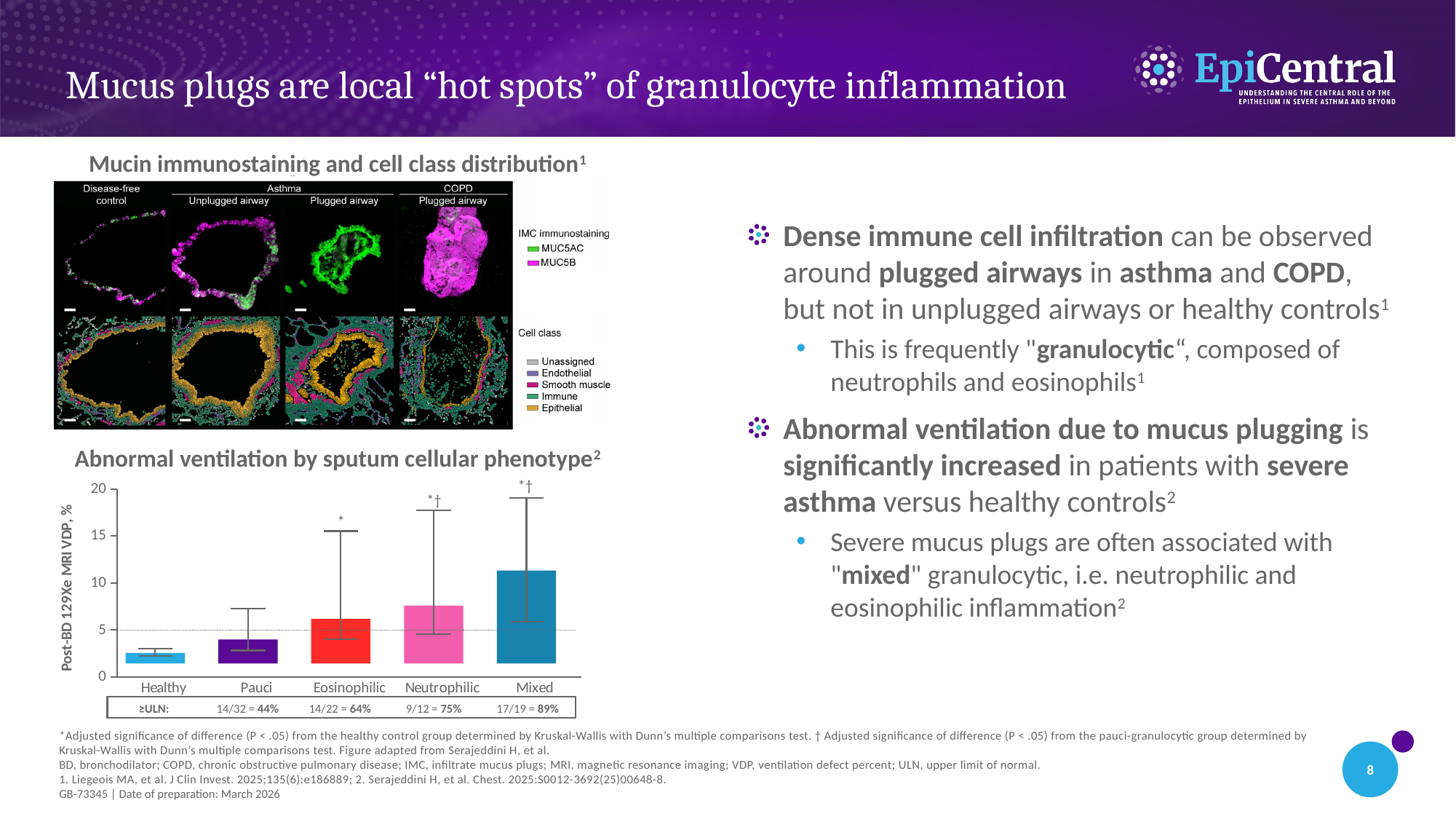
In the 'Abnormal ventilation by sputum cellular phenotype' chart, what is the ≥ULN fraction shown for the Eosinophilic group? 14/22 = 64% In the 'Abnormal ventilation by sputum cellular phenotype' chart, is the bar for Eosinophilic greater or less than 5? greater What kind of chart is 'Abnormal ventilation by sputum cellular phenotype'? Bar chart In the 'Abnormal ventilation by sputum cellular phenotype' chart, which bar is taller, Neutrophilic or Pauci? Neutrophilic In the 'Abnormal ventilation by sputum cellular phenotype' chart, which category has the highest bar? Mixed In the 'Abnormal ventilation by sputum cellular phenotype' chart, which category has the lowest bar? Healthy In the 'Abnormal ventilation by sputum cellular phenotype' chart, is the bar for Mixed greater or less than 10? greater In the 'Abnormal ventilation by sputum cellular phenotype' chart, what percentage of the Mixed group is ≥ULN? 89% What is the y-axis label of the 'Abnormal ventilation by sputum cellular phenotype' chart? Post-BD 129Xe MRI VDP, % In the 'Abnormal ventilation by sputum cellular phenotype' chart, is the bar for Healthy greater or less than 5? less How many sputum cellular phenotype categories are shown on the x axis of the 'Abnormal ventilation by sputum cellular phenotype' chart? 5 In the 'Abnormal ventilation by sputum cellular phenotype' chart, do the bar values rise or fall from Healthy to Mixed along the x axis? Rise